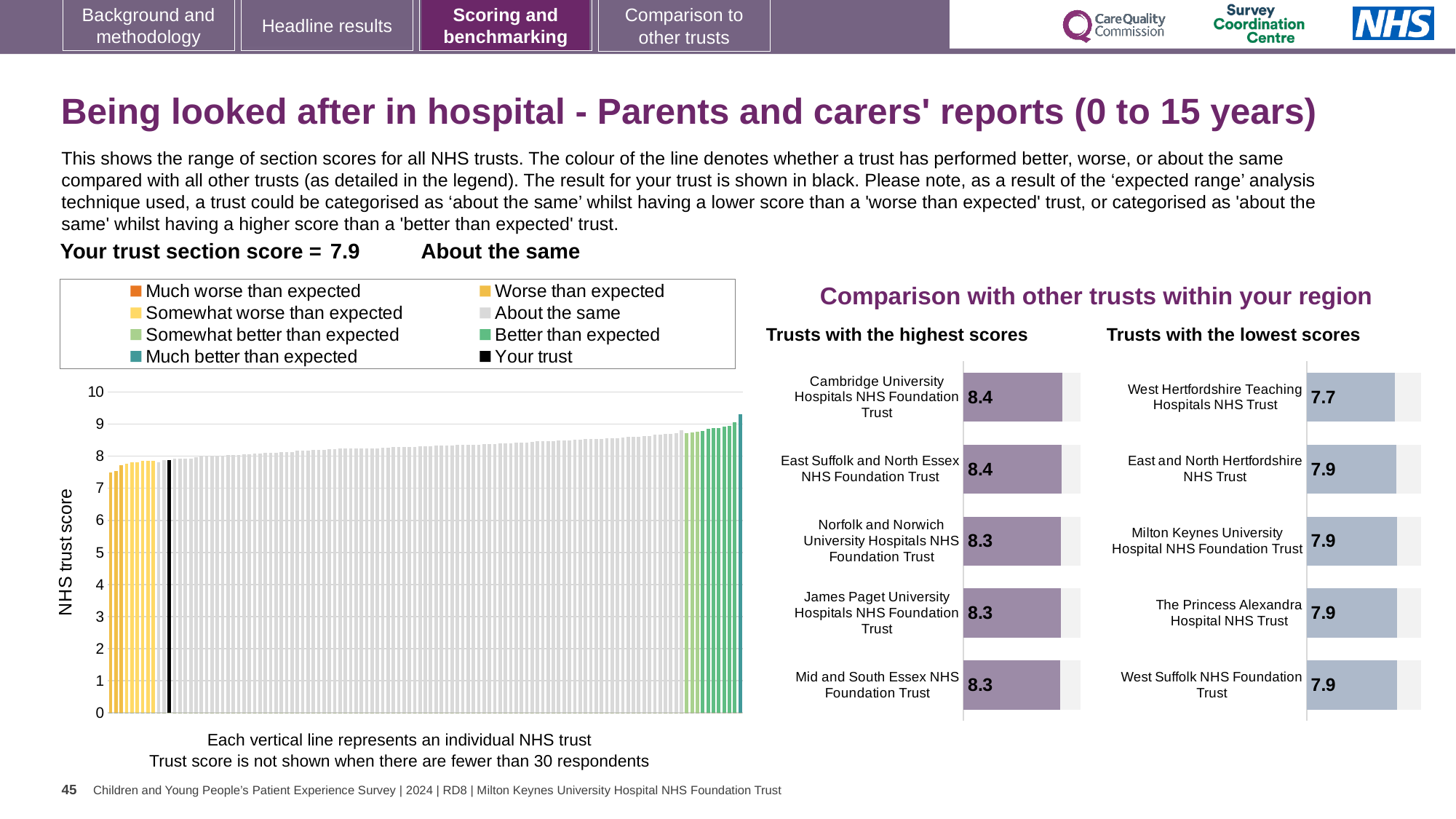
In the large chart on the left, is the value of the leftmost bar greater or less than 8? less In the 'Trusts with the highest scores' chart, what is the difference between the scores of Cambridge University Hospitals NHS Foundation Trust and Norfolk and Norwich University Hospitals NHS Foundation Trust? 0.1 In the 'Trusts with the lowest scores' chart, which trust has the lowest score? West Hertfordshire Teaching Hospitals NHS Trust How many trusts are listed in the 'Trusts with the lowest scores' chart? 5 What is the y-axis label of the large chart on the left? NHS trust score In the 'Trusts with the highest scores' chart, which has the larger score: East Suffolk and North Essex NHS Foundation Trust or James Paget University Hospitals NHS Foundation Trust? East Suffolk and North Essex NHS Foundation Trust In the large chart on the left, do the trust scores rise or fall from left to right? Rise In the 'Trusts with the lowest scores' chart, what is the score for West Hertfordshire Teaching Hospitals NHS Trust? 7.7 How many entries does the legend of the large chart on the left list? 8 What kind of chart is the large chart on the left showing NHS trust scores? Bar chart In the 'Trusts with the highest scores' chart, what is the score for Mid and South Essex NHS Foundation Trust? 8.3 In the 'Trusts with the highest scores' chart, what is the score for Cambridge University Hospitals NHS Foundation Trust? 8.4